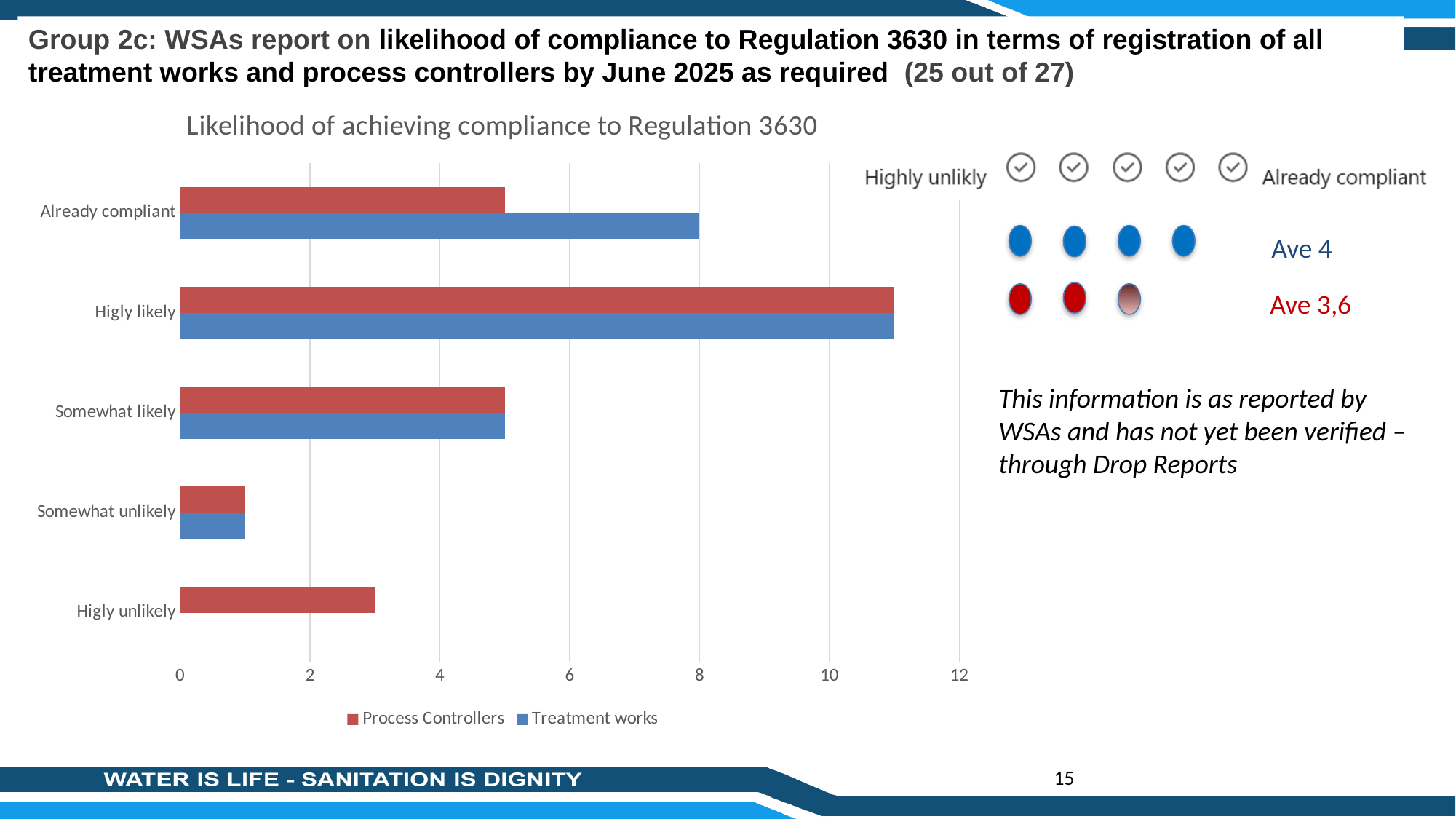
In the Already compliant category, which is larger: Process Controllers or Treatment works? Treatment works Is the value for Process Controllers in the Higly likely category greater or less than 10? greater Which category has the highest value for Treatment works? Higly likely Which category has the highest value for Process Controllers? Higly likely How many categories are shown on the chart's vertical axis? 5 Which category has the lowest value for Process Controllers? Somewhat unlikely Is the value for Process Controllers in the Higly unlikely category greater or less than 4? less What kind of chart is shown on the slide? bar chart What is the value for Treatment works in the Already compliant category? 8 How many series does the chart legend list? 2 What is the title of the chart? Likelihood of achieving compliance to Regulation 3630 Which colour represents the Process Controllers series in the chart? red